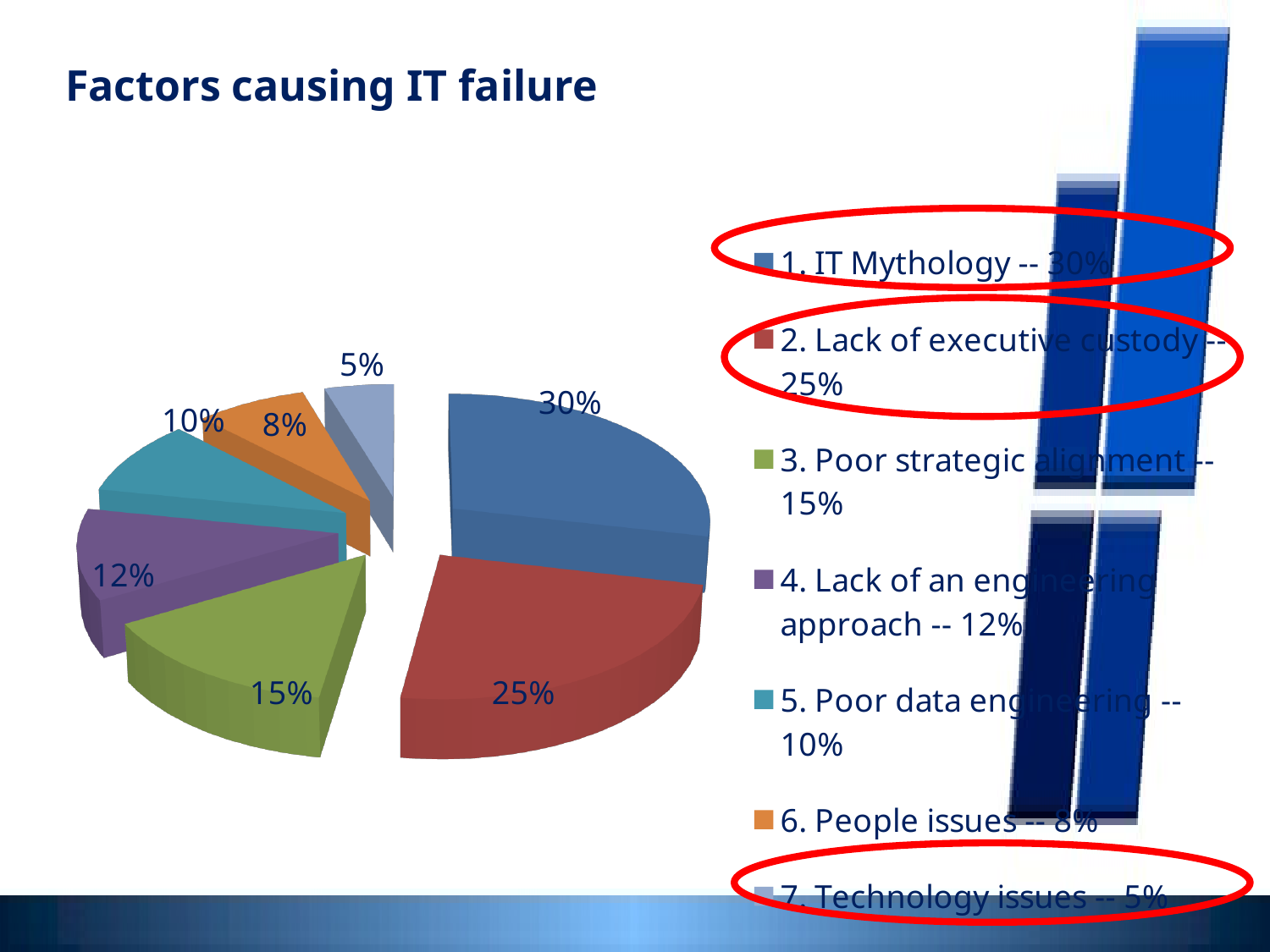
What kind of chart is shown on the slide? Pie chart What share of the pie does IT Mythology account for? 30% What is the value for Lack of executive custody? 25% Which factor has the smallest slice of the pie? 7. Technology issues What is the difference between the values for IT Mythology and Lack of executive custody? 5% Which is larger, the value for Poor data engineering or the value for People issues? Poor data engineering What is the value for Poor strategic alignment? 15% What is the combined share of Lack of an engineering approach and Poor data engineering? 22% What is the value for Technology issues? 5% Which factor has the largest slice of the pie? 1. IT Mythology How many slices does the pie chart have? 7 What is the title of the slide containing the pie chart? Factors causing IT failure